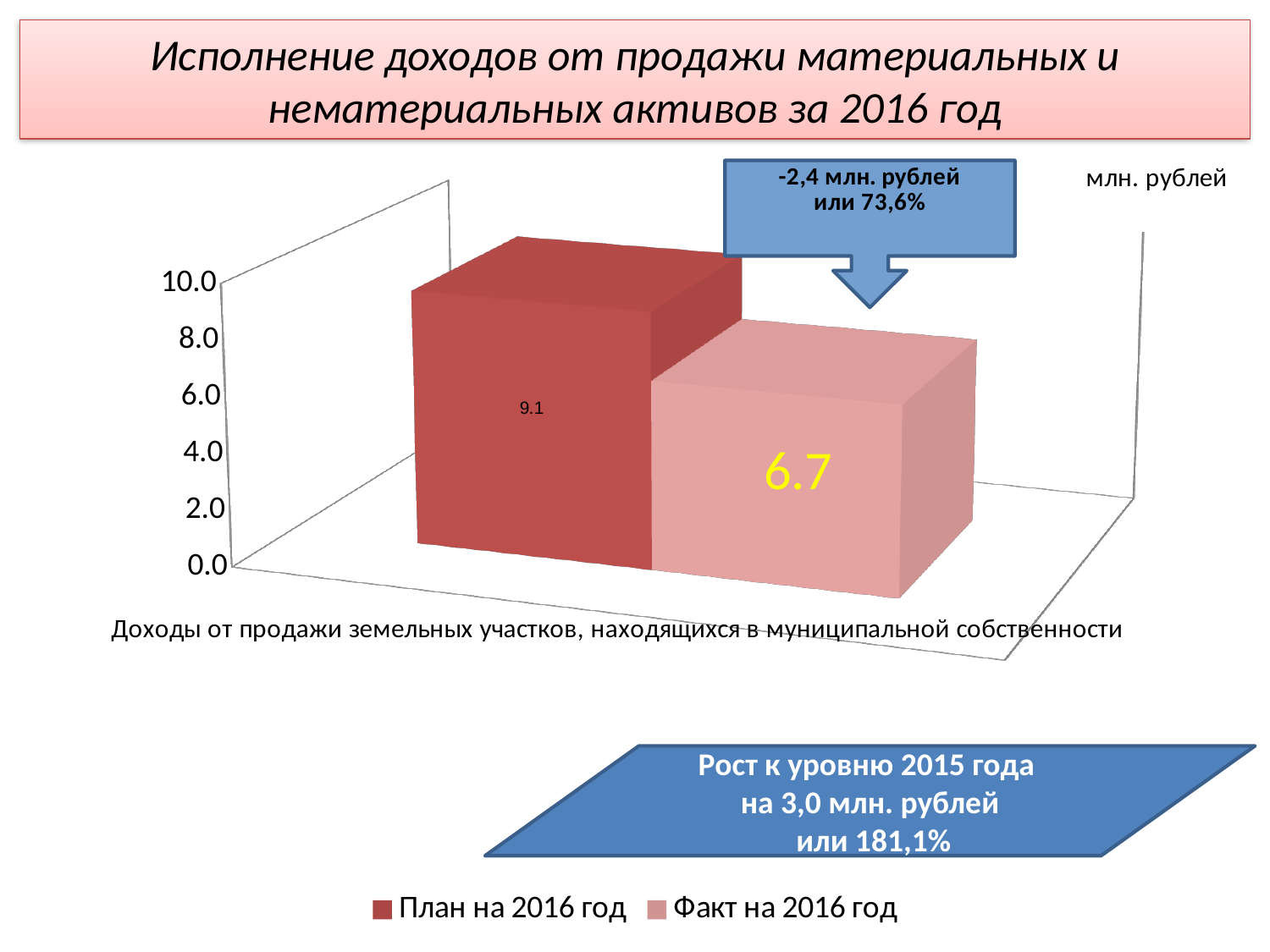
How many categories are shown on the x axis? 1 Is the value for План на 2016 год greater or less than 8.0? greater What unit is indicated for the chart values? млн. рублей What is the name of the category shown on the x axis? Доходы от продажи земельных участков, находящихся в муниципальной собственности Which series has the higher value, План на 2016 год or Факт на 2016 год? План на 2016 год Which series has the lowest value? Факт на 2016 год What is the value for План на 2016 год? 9.1 Is the value for Факт на 2016 год greater or less than 8.0? less What is the difference between the План на 2016 год value and the Факт на 2016 год value? 2.4 How many series does the legend list? 2 What kind of chart is shown on the slide? bar chart What is the value for Факт на 2016 год? 6.7